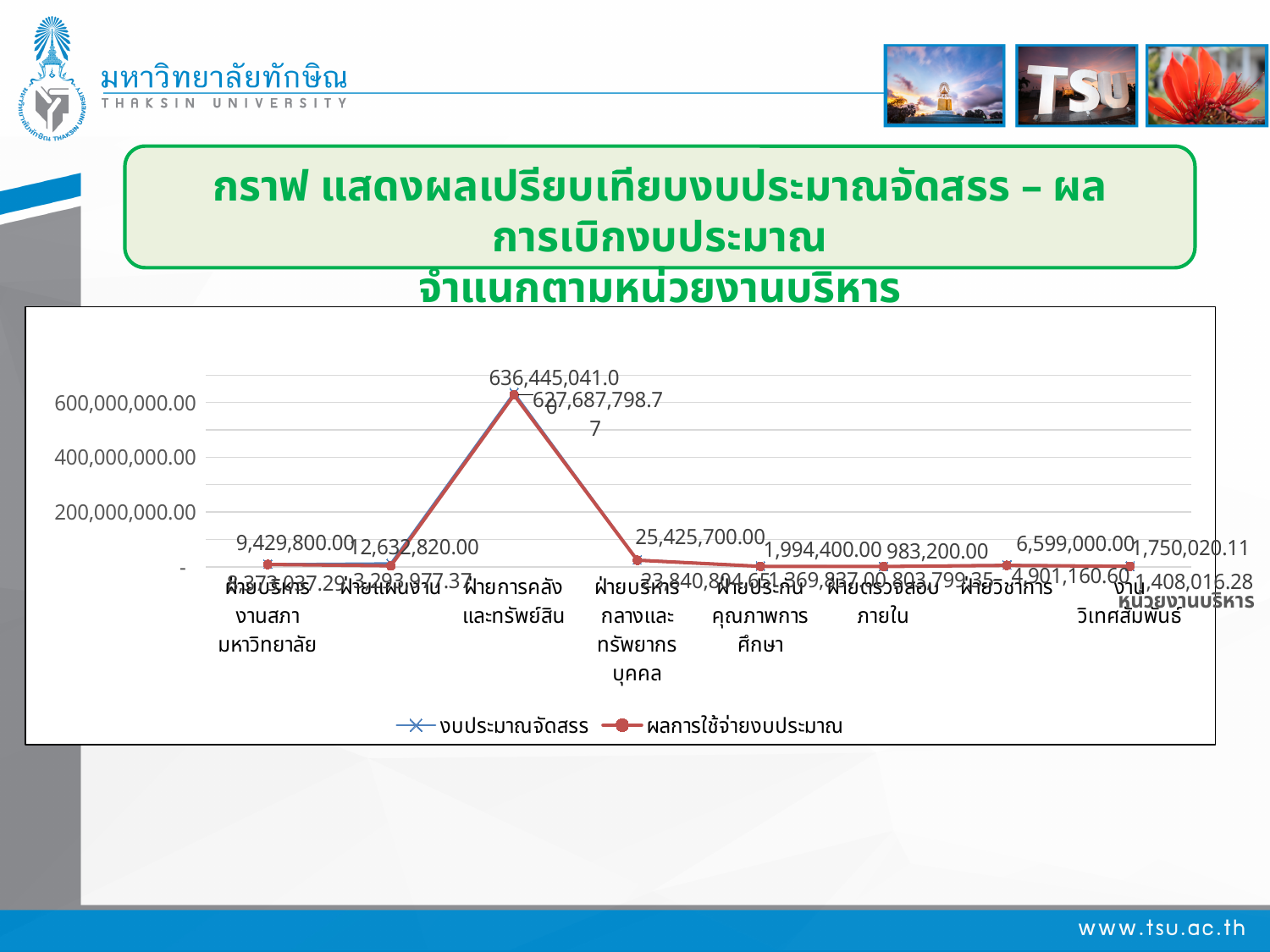
What is the difference between งบประมาณจัดสรร and ผลการใช้จ่ายงบประมาณ for ฝ่ายการคลังและทรัพย์สิน? 8,757,242.23 Which unit has the highest งบประมาณจัดสรร? ฝ่ายการคลังและทรัพย์สิน What is the งบประมาณจัดสรร value for ฝ่ายการคลังและทรัพย์สิน? 636,445,041.00 What is the ผลการใช้จ่ายงบประมาณ value for งานวิเทศสัมพันธ์? 1,408,016.28 How many series does the legend list? 2 How many administrative units (categories) are plotted along the x axis? 8 What kind of chart is shown on the slide? line chart What is the ผลการใช้จ่ายงบประมาณ value for ฝ่ายการคลังและทรัพย์สิน? 627,687,798.77 What is the งบประมาณจัดสรร value for ฝ่ายวิชาการ? 6,599,000.00 Which series is drawn with the red line and circle markers? ผลการใช้จ่ายงบประมาณ Is the งบประมาณจัดสรร value for ฝ่ายการคลังและทรัพย์สิน greater or less than 600,000,000.00? greater Which unit has the lowest งบประมาณจัดสรร? ฝ่ายตรวจสอบภายใน